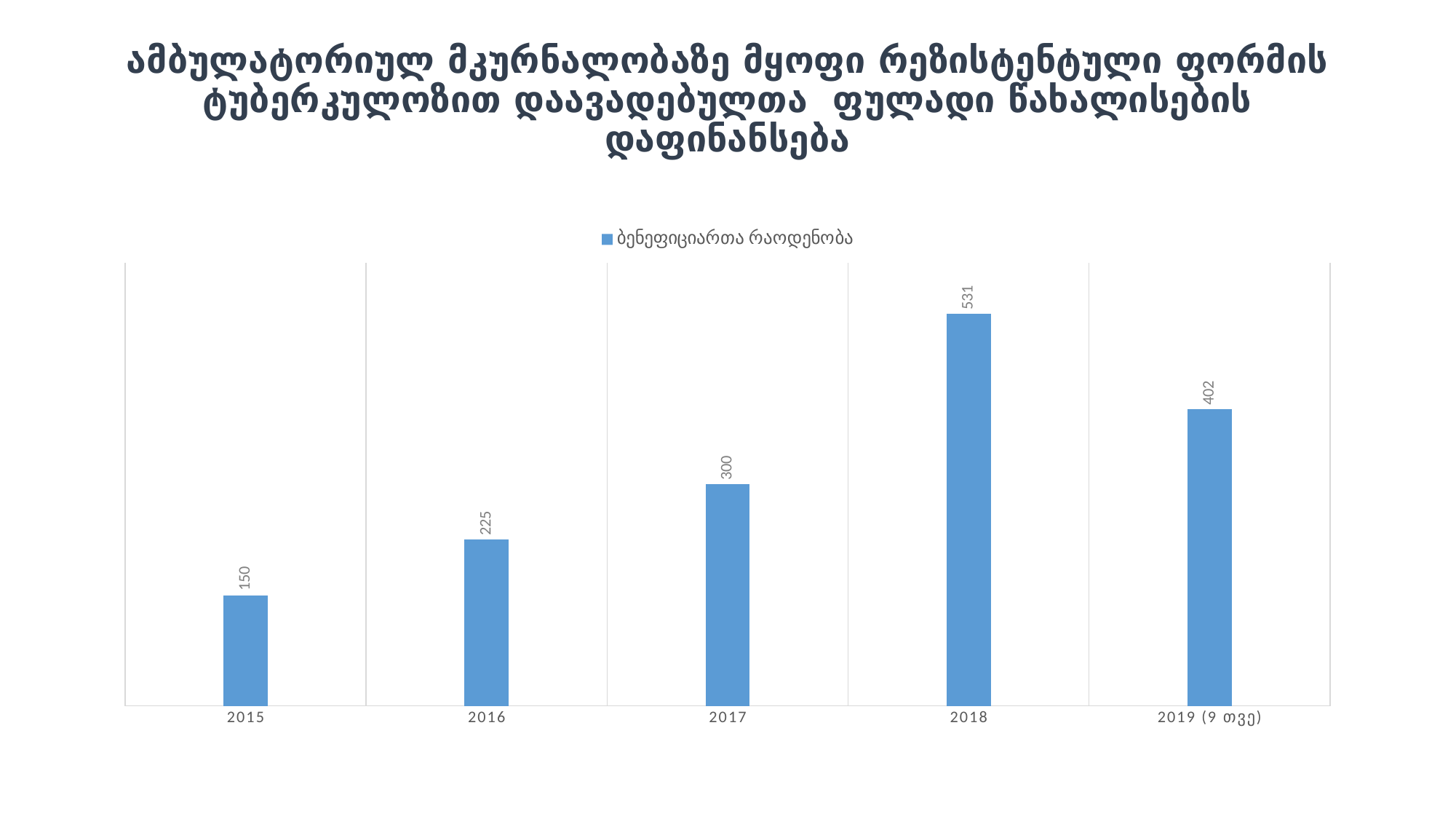
What kind of chart is shown on the slide? bar chart What is the legend entry for the series? ბენეფიციართა რაოდენობა What is the value for 2019 (9 თვე)? 402 What is the value for 2015? 150 What is the difference between the values for 2018 and 2017? 231 Which year has the lowest value? 2015 How many series does the legend list? 1 What is the difference between the values for 2016 and 2015? 75 Which is larger, the value for 2019 (9 თვე) or the value for 2017? 2019 (9 თვე) Which year has the highest value? 2018 How many categories are shown on the x axis? 5 What is the value for 2017? 300